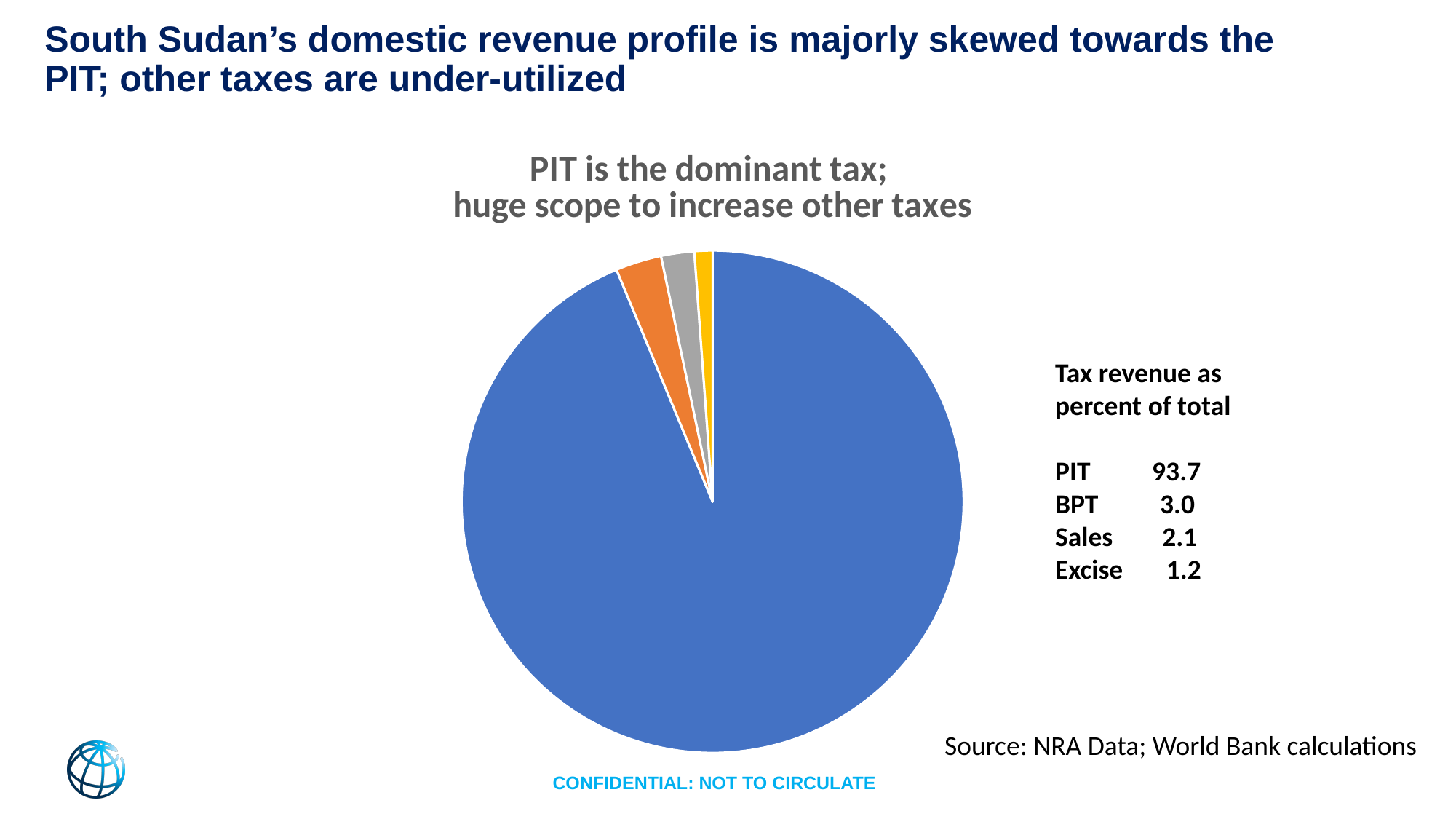
Which has a larger share of tax revenue, Sales or Excise? Sales What is the title of the pie chart? PIT is the dominant tax; huge scope to increase other taxes What kind of chart is shown on the slide? pie chart What is the tax revenue share for Sales as a percent of total? 2.1 What is the tax revenue share for PIT as a percent of total? 93.7 Which tax accounts for the largest share of tax revenue? PIT What is the difference between the PIT share and the BPT share of tax revenue? 90.7 How many tax categories are shown in the pie chart? 4 What is the tax revenue share for BPT as a percent of total? 3.0 What is the combined share of tax revenue from BPT, Sales and Excise? 6.3 What is the tax revenue share for Excise as a percent of total? 1.2 Which tax accounts for the smallest share of tax revenue? Excise